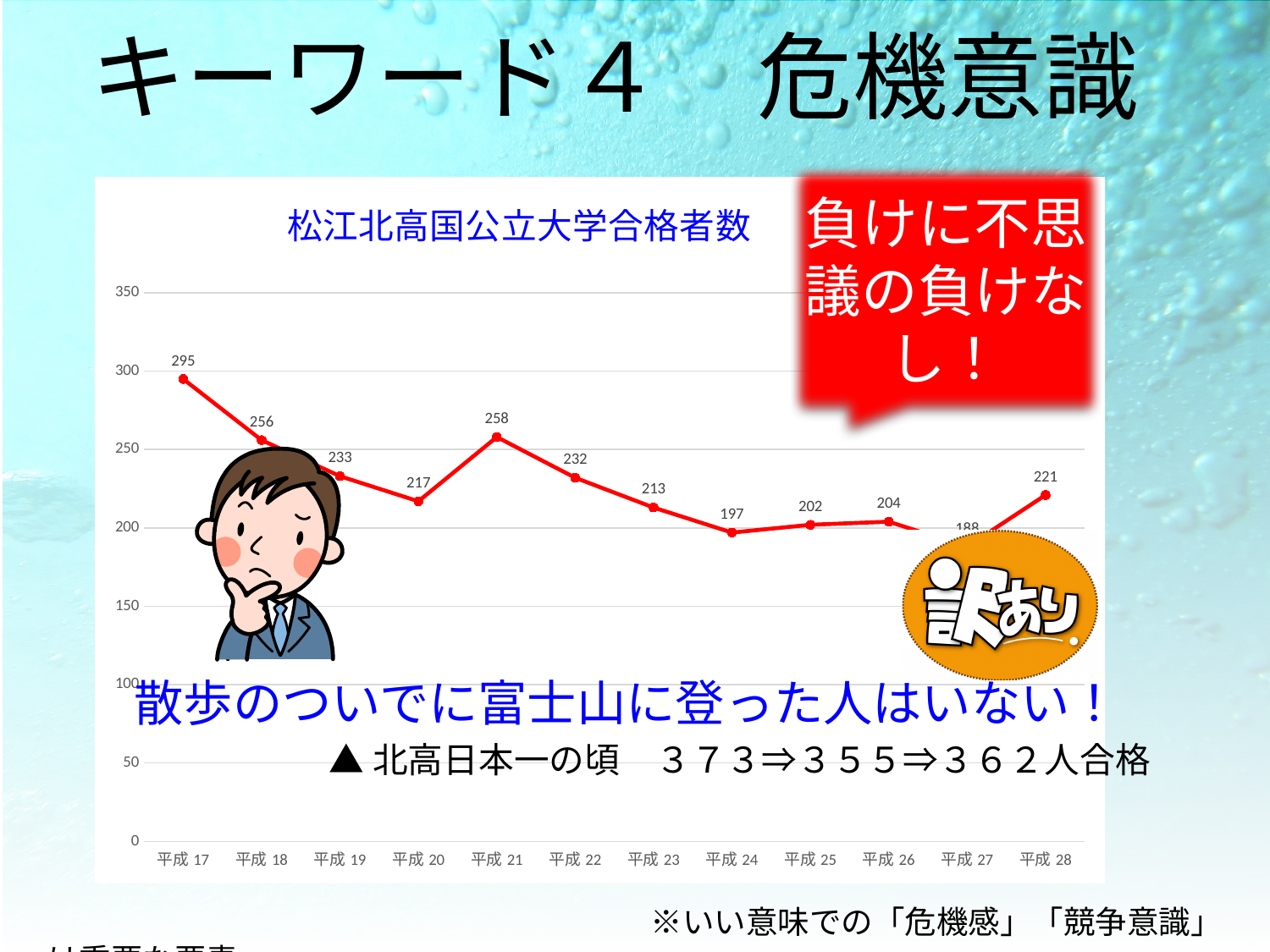
What is the value for 平成 17 in the chart? 295 Which is larger, the value for 平成 21 or the value for 平成 22? 平成 21 What is the value for 平成 21 in the chart? 258 Is the value for 平成 24 greater or less than 200? less What kind of chart is shown on the slide? line chart Which year has the highest value in the chart? 平成 17 What is the difference between the values for 平成 17 and 平成 18? 39 How many years are plotted on the x axis of the chart? 12 Do the values rise or fall from 平成 17 to 平成 20? fall What is the value for 平成 28 in the chart? 221 What is the difference between the values for 平成 28 and 平成 26? 17 What is the value for 平成 25 in the chart? 202